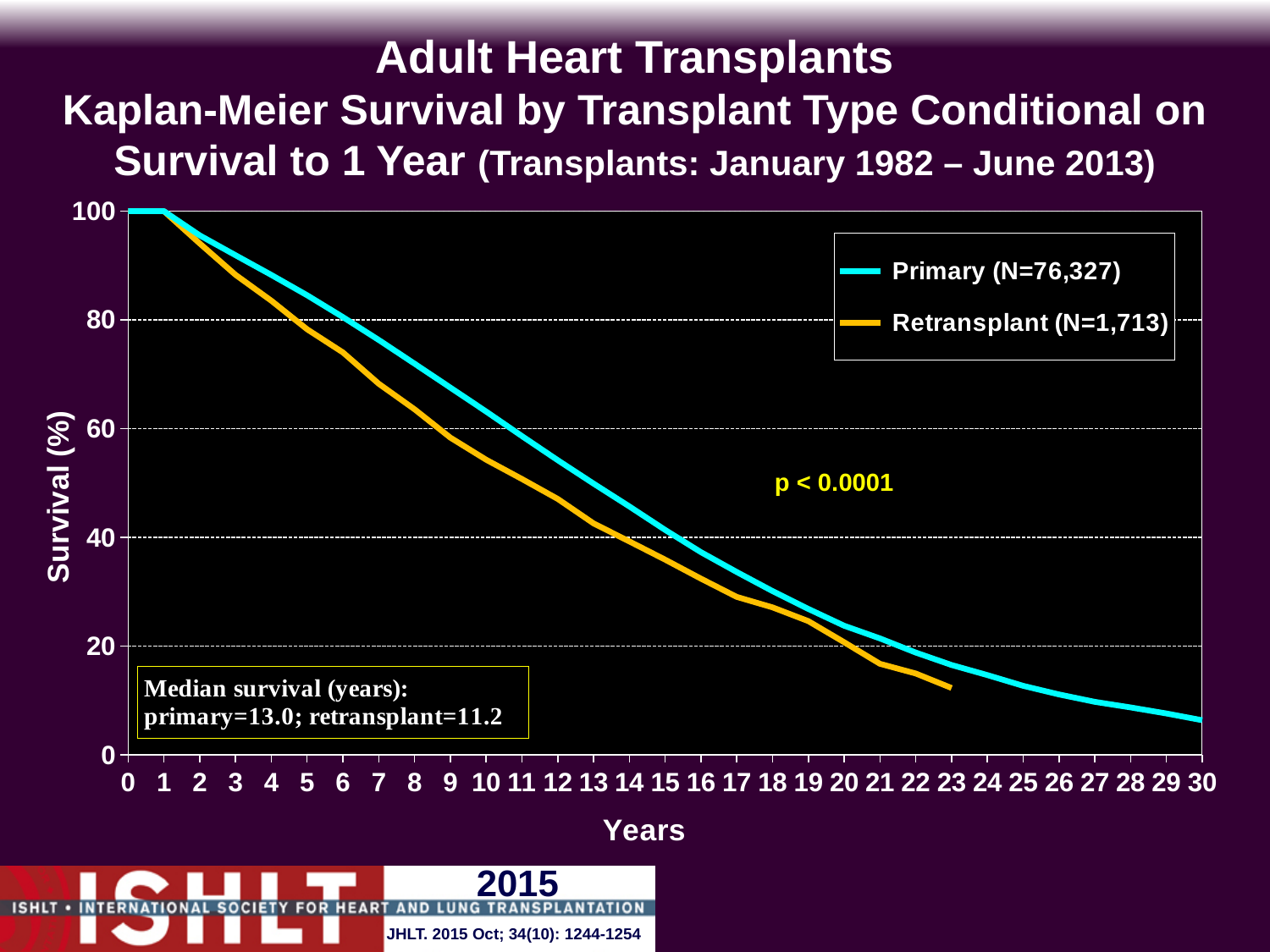
What is the N for the Retransplant series in the legend? 1,713 Do the survival curves rise or fall as years increase? fall Is the survival value for the Retransplant series at 15 years greater or less than 40? less What kind of chart is shown on the slide? line chart How many series does the legend list? 2 What is the median survival in years for retransplants? 11.2 Is the survival value for the Primary series at 30 years greater or less than 20? less What is the N for the Primary series in the legend? 76,327 Is the survival value for the Primary series at 10 years greater or less than 60? greater What is the difference in median survival (years) between primary transplants and retransplants? 1.8 What is the median survival in years for primary transplants? 13.0 At 10 years, which series has the higher survival, Primary or Retransplant? Primary